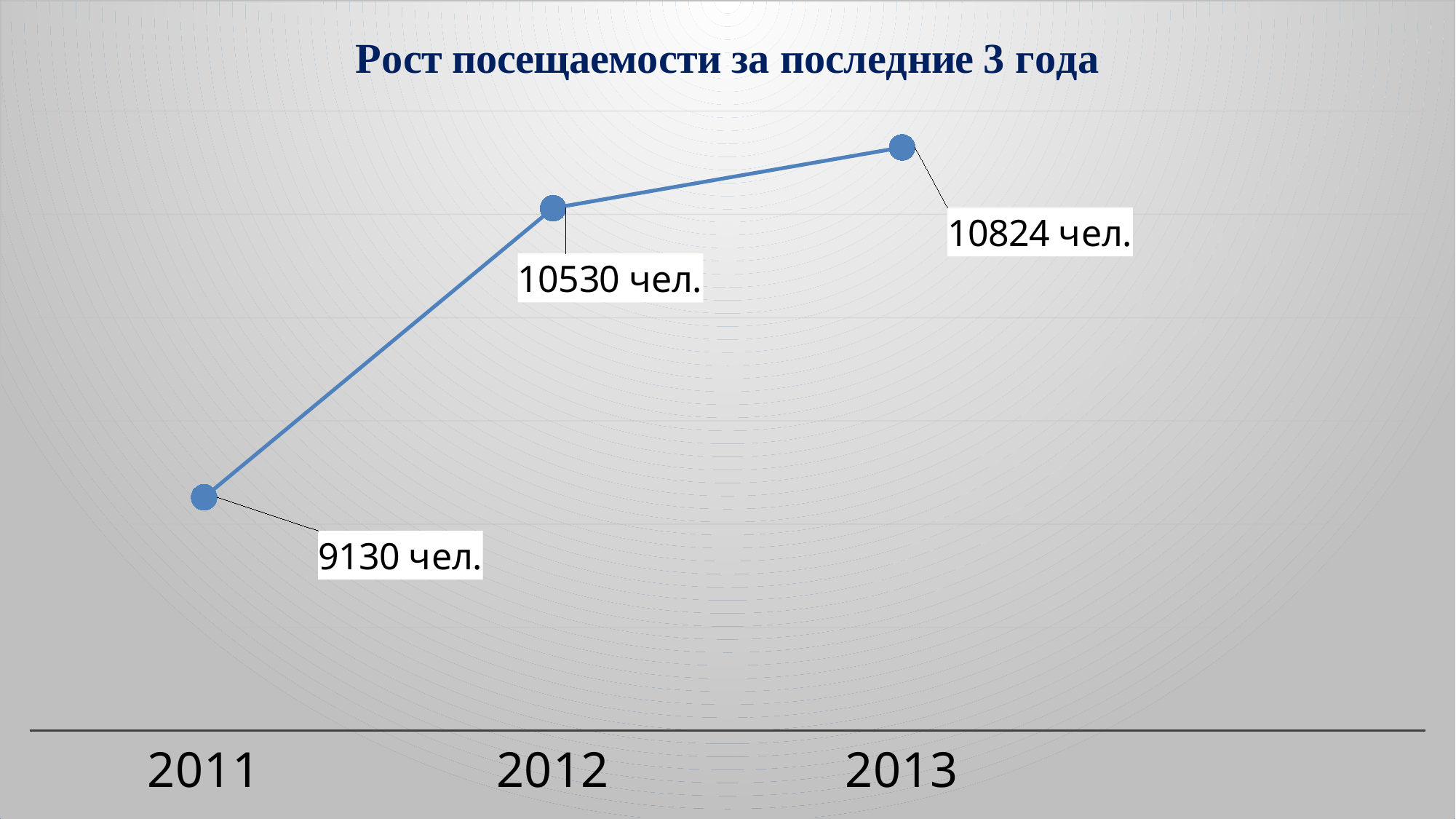
Which year has the highest attendance? 2013 What is the attendance value for 2011? 9130 чел. What is the difference in attendance between 2013 and 2012? 294 чел. Which year has the larger attendance, 2011 or 2012? 2012 Do the attendance values rise or fall from 2011 to 2013? Rise What is the attendance value for 2013? 10824 чел. What is the attendance value for 2012? 10530 чел. How many years (data points) are plotted on the chart? 3 What kind of chart is shown on the slide? Line chart What is the title of the chart? Рост посещаемости за последние 3 года What is the difference in attendance between 2012 and 2011? 1400 чел. Which year has the lowest attendance? 2011